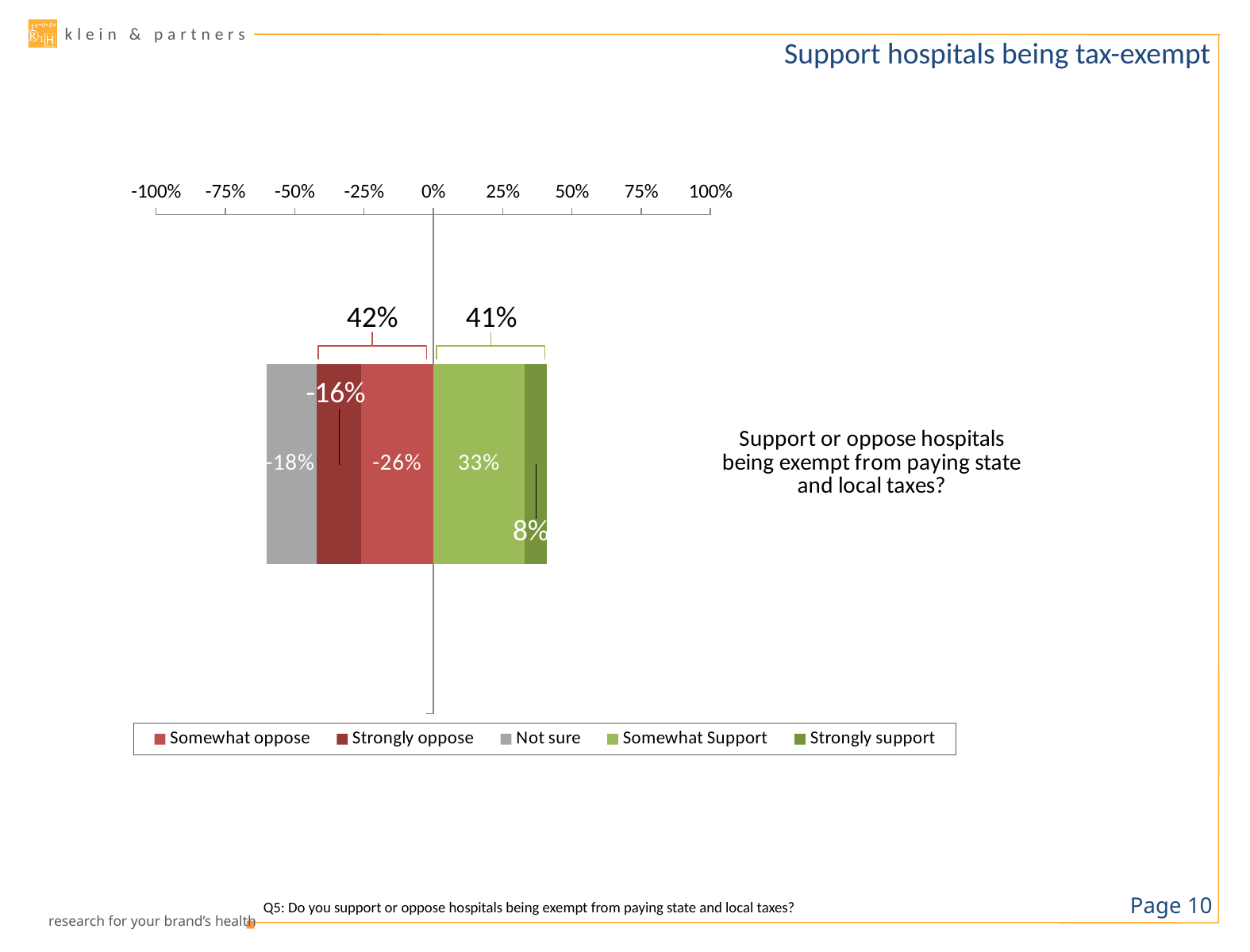
What combined percentage is shown above the oppose segments? 42% How many series does the legend list? 5 What combined percentage is shown above the support segments? 41% Which segment has the smallest absolute value? Strongly support What value is shown for Strongly oppose? -16% What kind of chart is shown on the slide? Bar chart What value is shown for Somewhat oppose? -26% What value is shown for Somewhat Support? 33% What is the difference between the Somewhat Support value and the Strongly support value? 25% What value is shown for Strongly support? 8% What value is shown for Not sure? -18% Which segment has the largest absolute value? Somewhat Support